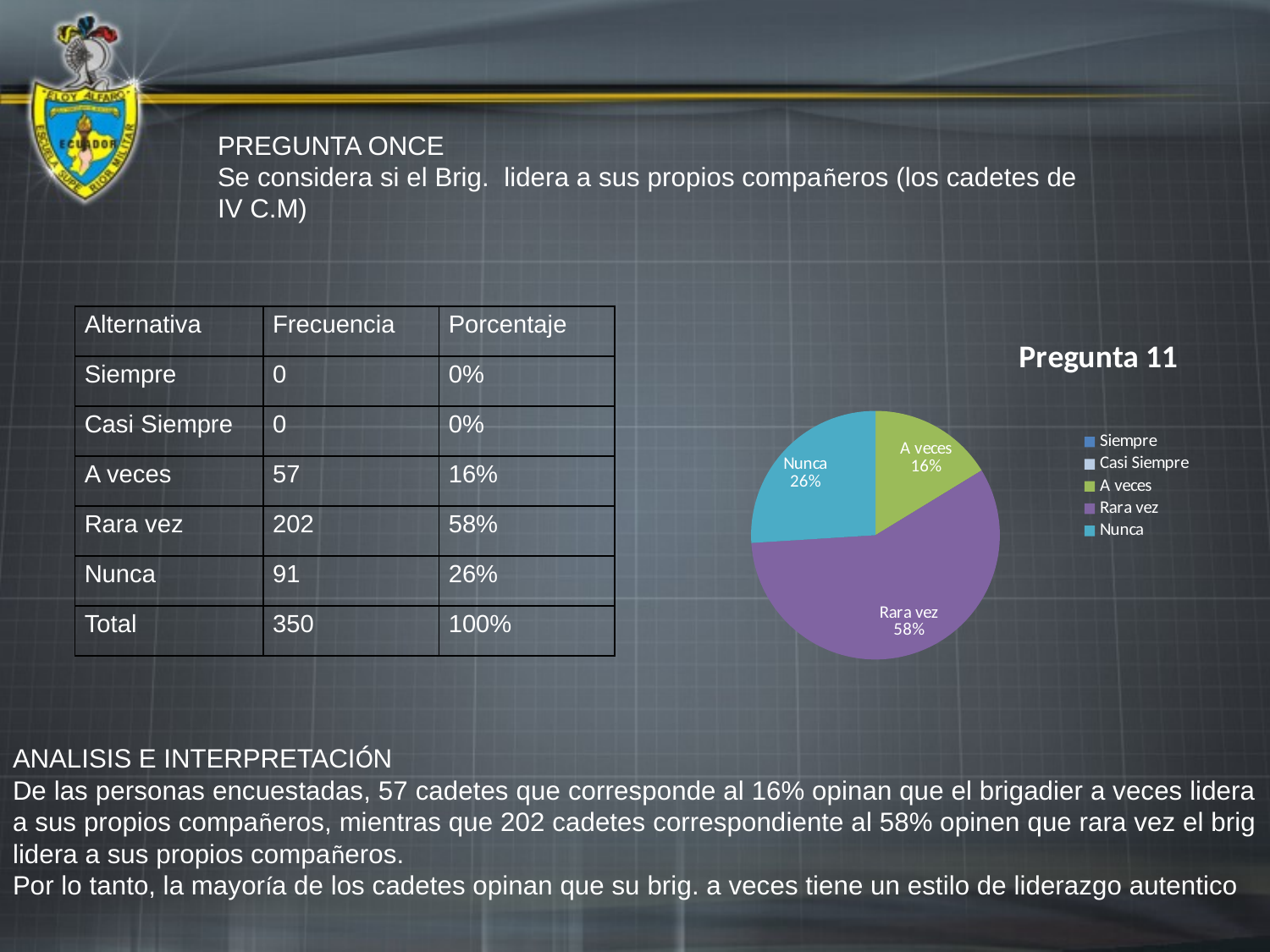
What is the difference in percentage points between the 'Rara vez' and 'Nunca' slices? 32% What kind of chart is shown on the slide? pie chart How many slices with visible labels are shown in the pie? 3 What share of the pie does the 'Rara vez' slice represent? 58% What is the title of the chart? Pregunta 11 How many entries does the chart legend list? 5 Which category has the largest slice of the pie? Rara vez Which slice is larger, 'Nunca' or 'A veces'? Nunca What colour is the 'Rara vez' slice in the pie chart? purple What share of the pie does the 'Nunca' slice represent? 26% What share of the pie does the 'A veces' slice represent? 16% Which of the labelled slices is the smallest? A veces